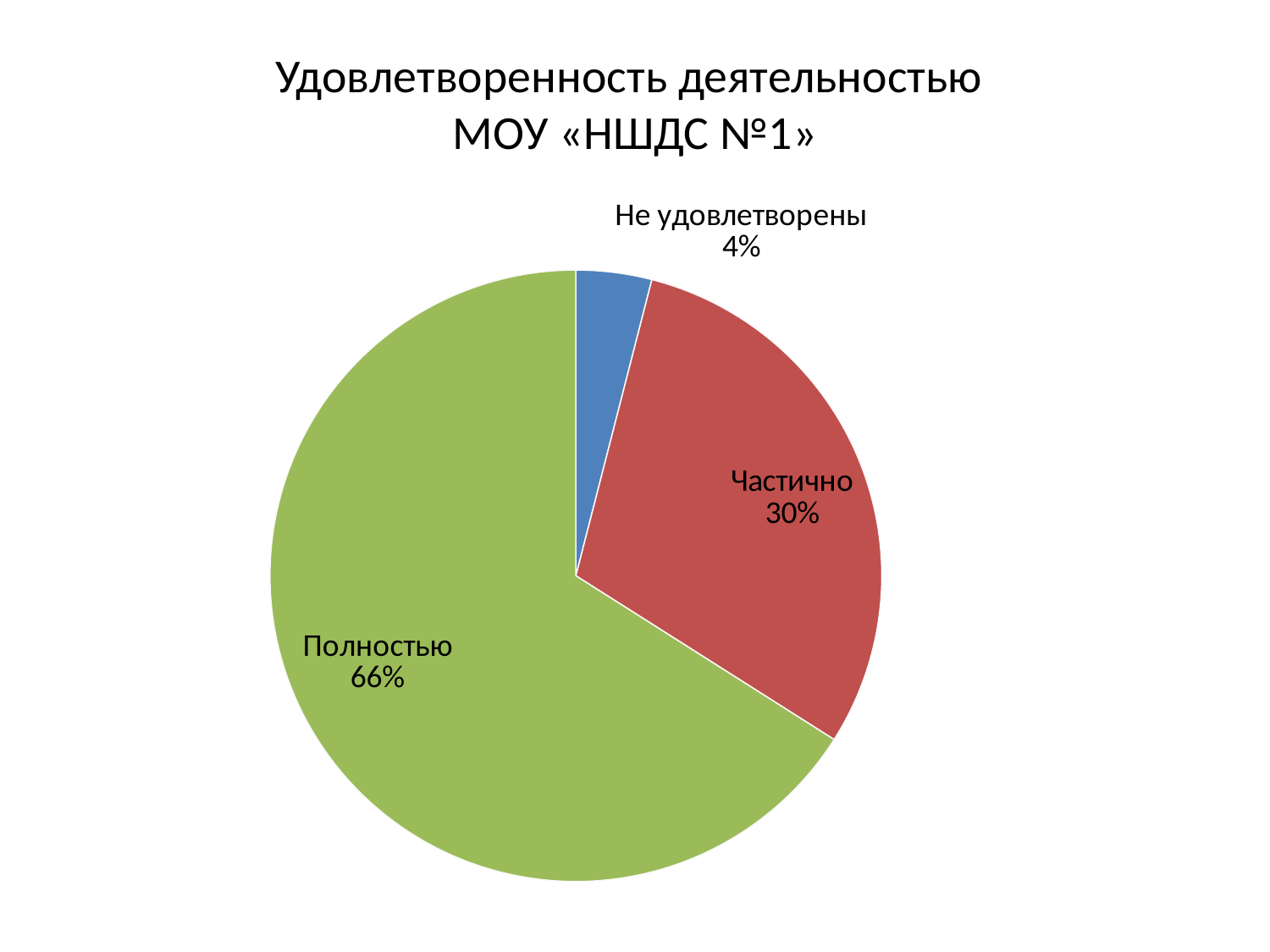
How many slices does the pie chart have? 3 What share of the pie does "Полностью" represent? 66% What share of the pie does "Частично" represent? 30% What is the difference in percentage points between "Полностью" and "Частично"? 36 Which category has the largest slice of the pie? Полностью What is the difference in percentage points between "Частично" and "Не удовлетворены"? 26 Which is larger, the share for "Частично" or the share for "Не удовлетворены"? Частично Which category has the smallest slice of the pie? Не удовлетворены What is the title of the chart on the slide? Удовлетворенность деятельностью МОУ «НШДС №1» What kind of chart is shown on the slide? pie chart What share of the pie does "Не удовлетворены" represent? 4% What colour is the slice for "Полностью"? green